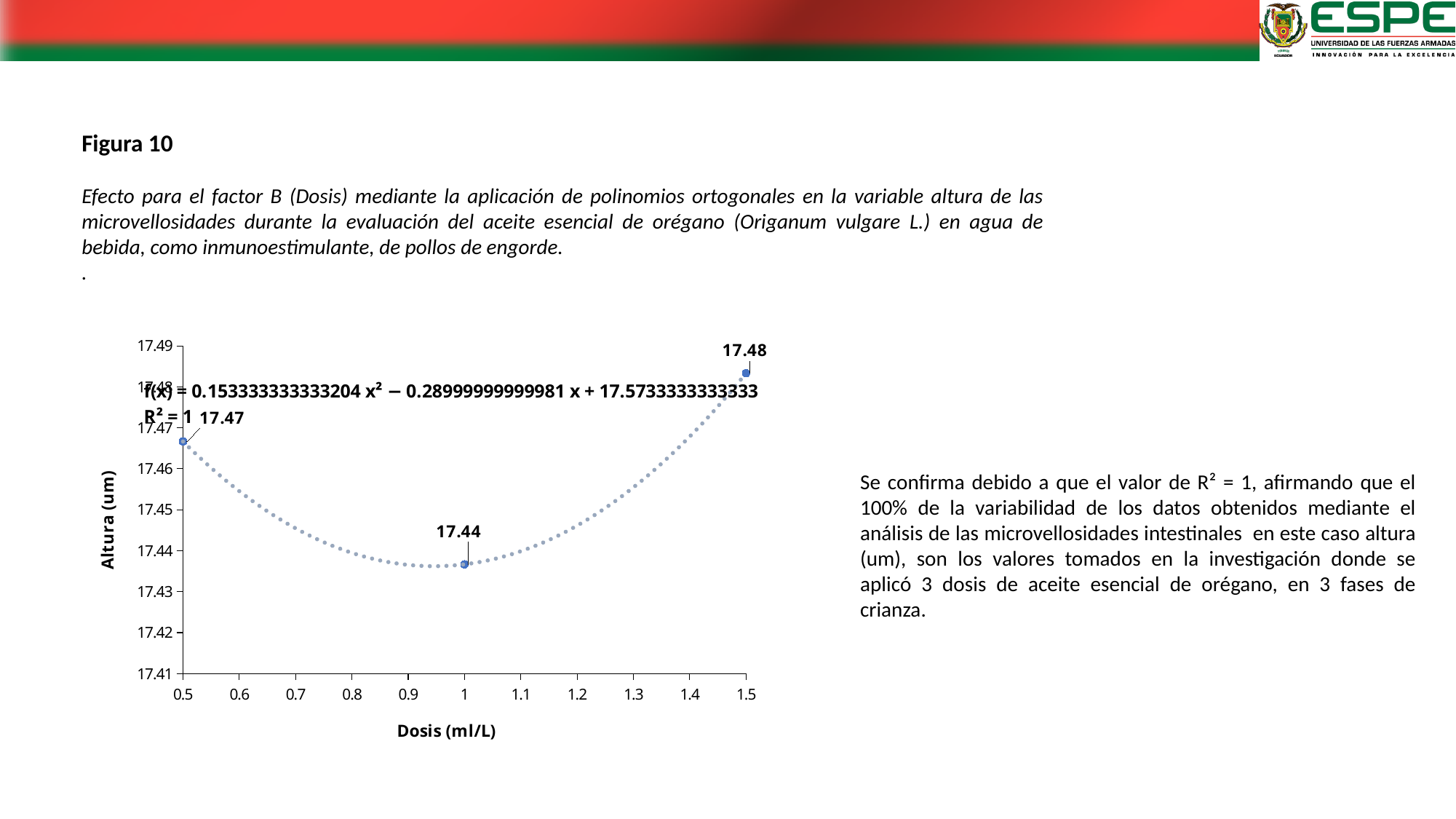
Which is larger, the height at dose 0.5 or the height at dose 1? dose 0.5 Which dose gives the lowest height value? 1 What is the label of the x axis? Dosis (ml/L) What is the height (Altura) value at a dose of 1.5 ml/L? 17.48 What is the height (Altura) value at a dose of 0.5 ml/L? 17.47 How many data points are plotted on the chart? 3 Is the height value at dose 1 greater or less than 17.45? less What is the R² value shown on the chart? 1 What kind of chart is shown on the slide? scatter chart Which dose gives the highest height value? 1.5 What is the height (Altura) value at a dose of 1 ml/L? 17.44 What is the difference between the height at dose 1.5 and the height at dose 1? 0.04